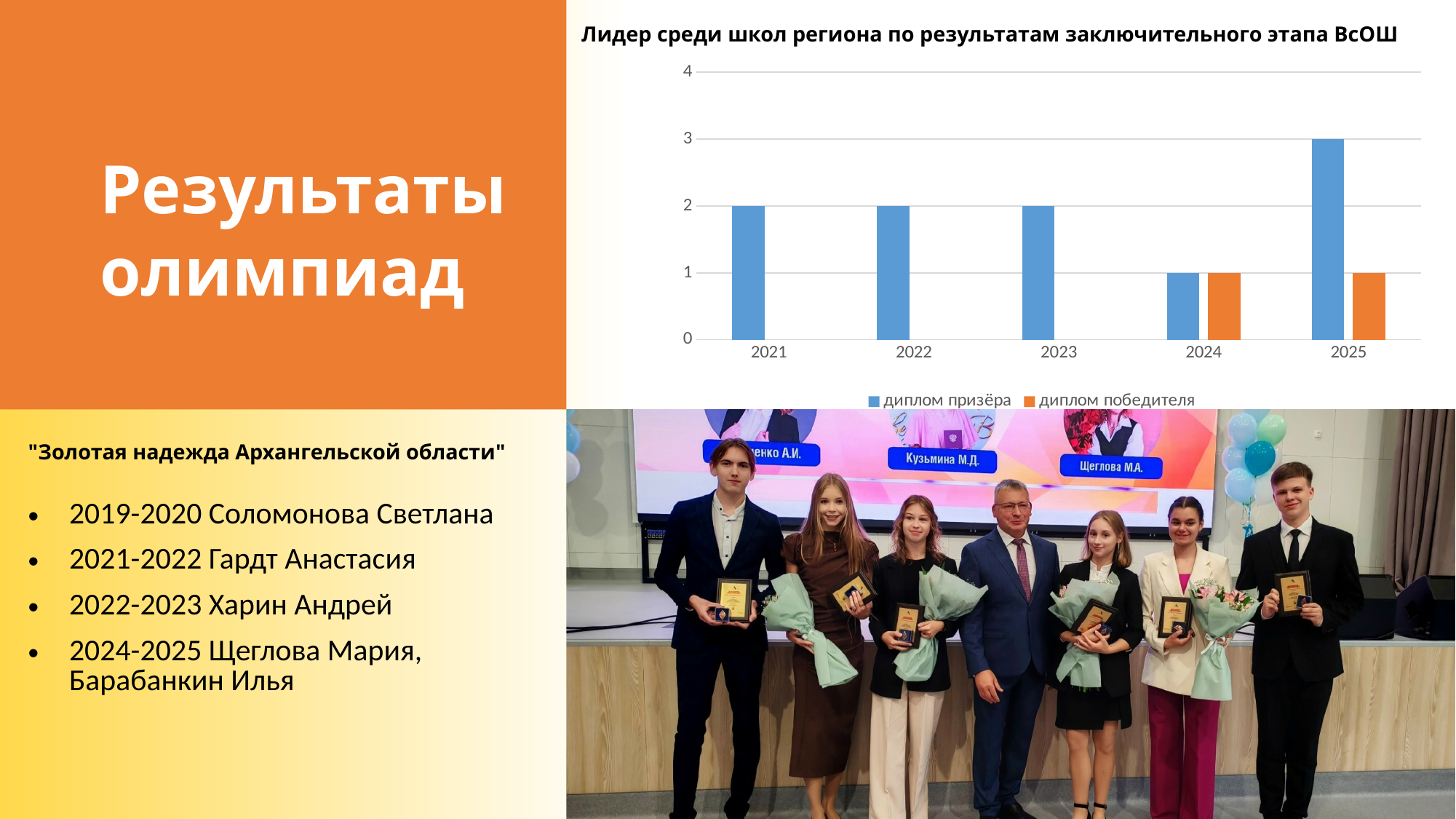
What is the value for диплом победителя in 2025? 1 What is the title of the chart? Лидер среди школ региона по результатам заключительного этапа ВсОШ What is the value for диплом призёра in 2024? 1 Which is larger in 2025: диплом призёра or диплом победителя? диплом призёра What is the value for диплом призёра in 2025? 3 What is the value for диплом призёра in 2021? 2 What is the difference between диплом призёра in 2025 and in 2024? 2 How many years are shown on the x axis of the chart? 5 How many series does the chart legend list? 2 What kind of chart is shown on the slide? bar chart In which year is the value for диплом призёра highest? 2025 In which year is the value for диплом призёра lowest? 2024